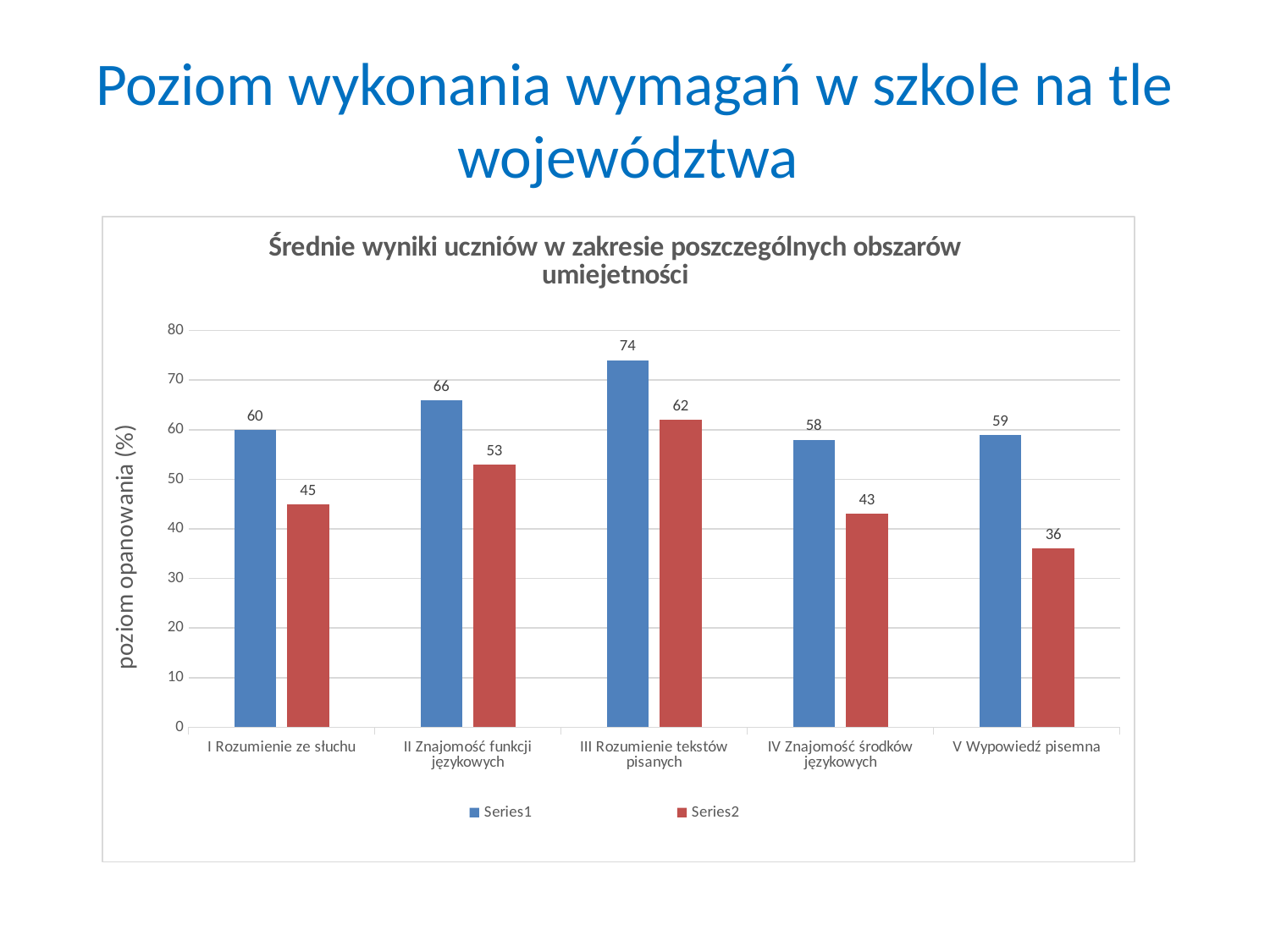
What is the Series2 value for V Wypowiedź pisemna? 36 What kind of chart is shown on the slide? bar chart Which is larger: the Series1 value for II Znajomość funkcji językowych or the Series1 value for V Wypowiedź pisemna? II Znajomość funkcji językowych What is the label of the vertical axis? poziom opanowania (%) What is the Series2 value for I Rozumienie ze słuchu? 45 What is the difference between Series1 and Series2 for IV Znajomość środków językowych? 15 What is the difference between Series1 and Series2 for V Wypowiedź pisemna? 23 Which category has the highest Series1 value? III Rozumienie tekstów pisanych How many series does the legend list? 2 What is the Series1 value for III Rozumienie tekstów pisanych? 74 Which category has the lowest Series2 value? V Wypowiedź pisemna How many categories are shown on the x axis? 5